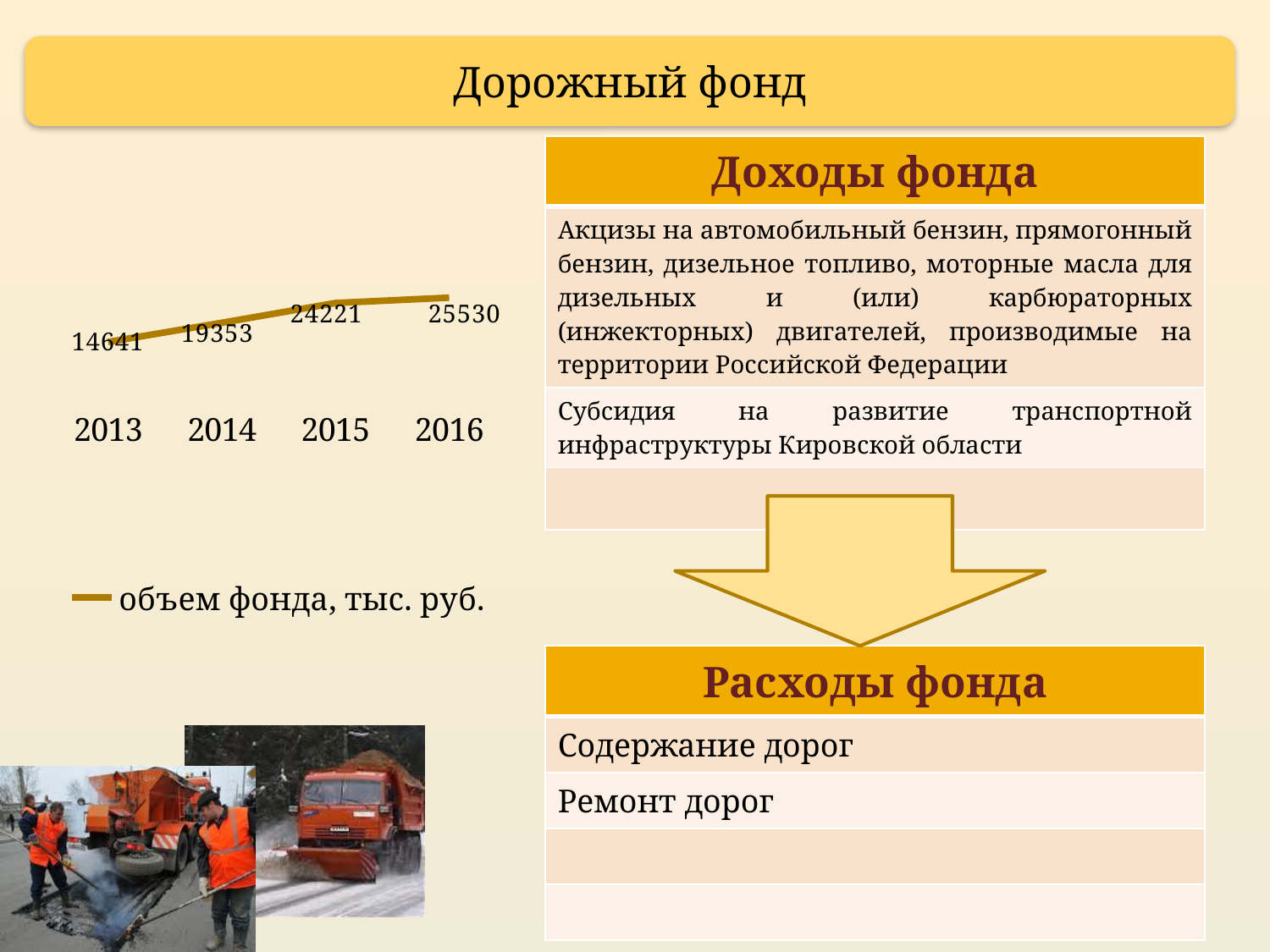
Which is larger, the value for 2014 or the value for 2015? 2015 What is the value of объем фонда, тыс. руб. for 2016? 25530 What is the value of объем фонда, тыс. руб. for 2013? 14641 Do the values rise or fall from 2013 to 2016? rise How many years are plotted on the chart? 4 Which year has the highest value of объем фонда? 2016 What is the value of объем фонда, тыс. руб. for 2014? 19353 What is the value of объем фонда, тыс. руб. for 2015? 24221 What is the difference between the values for 2015 and 2014? 4868 What is the difference between the values for 2016 and 2013? 10889 Which year has the lowest value of объем фонда? 2013 What kind of chart is shown on the slide? line chart